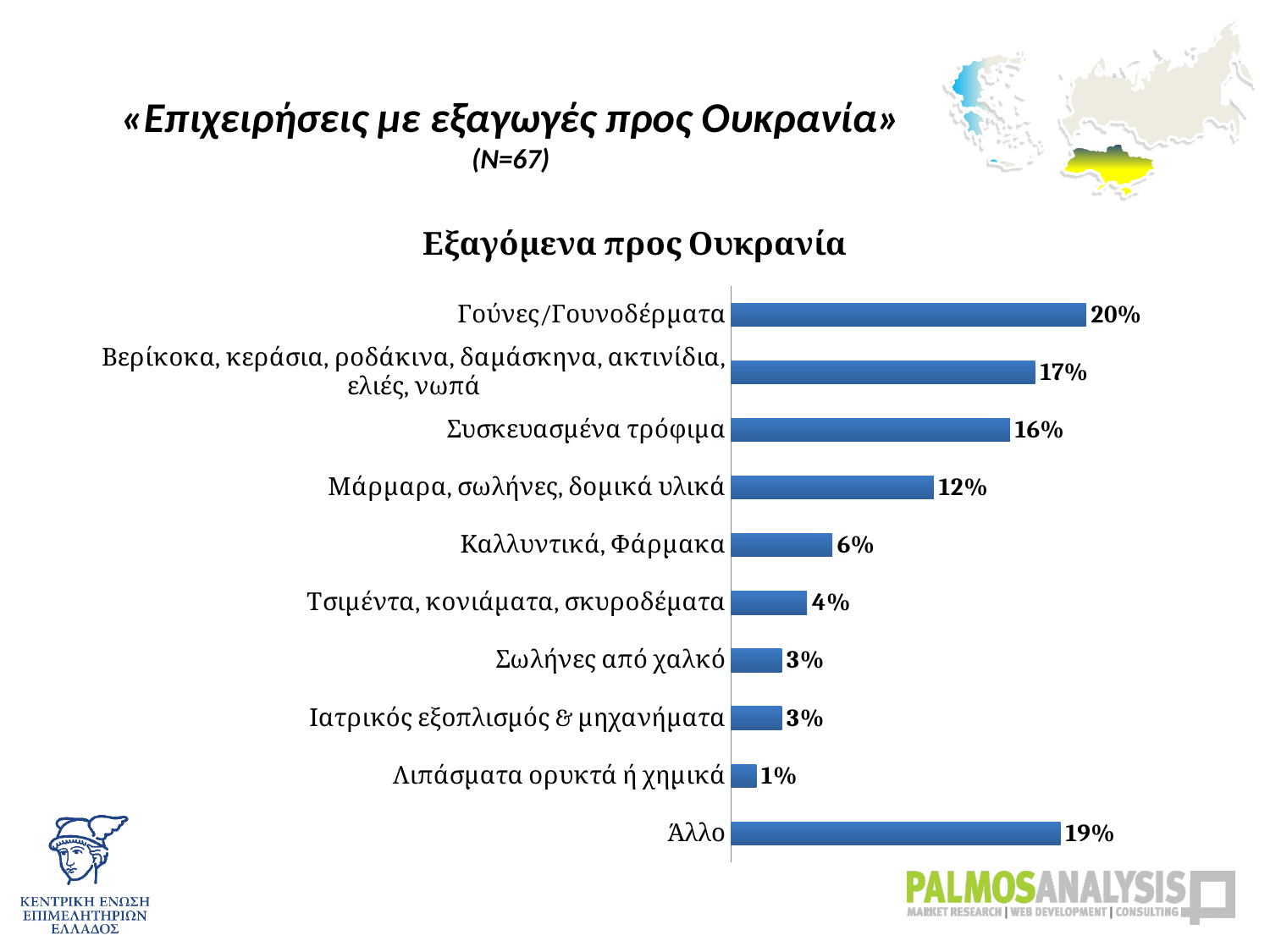
What is the value for Συσκευασμένα τρόφιμα? 16% What is the difference between the values for Συσκευασμένα τρόφιμα and Καλλυντικά, Φάρμακα? 10% What is the value for Μάρμαρα, σωλήνες, δομικά υλικά? 12% What is the difference between the values for Γούνες/Γουνοδέρματα and Άλλο? 1% Which is larger, the value for Τσιμέντα, κονιάματα, σκυροδέματα or the value for Καλλυντικά, Φάρμακα? Καλλυντικά, Φάρμακα How many categories are shown in the chart? 10 What is the value for Γούνες/Γουνοδέρματα? 20% What is the value for Λιπάσματα ορυκτά ή χημικά? 1% Which category has the lowest value? Λιπάσματα ορυκτά ή χημικά Which category has the highest value? Γούνες/Γουνοδέρματα What kind of chart is shown on the slide? Bar chart What is the title of the chart? Εξαγόμενα προς Ουκρανία